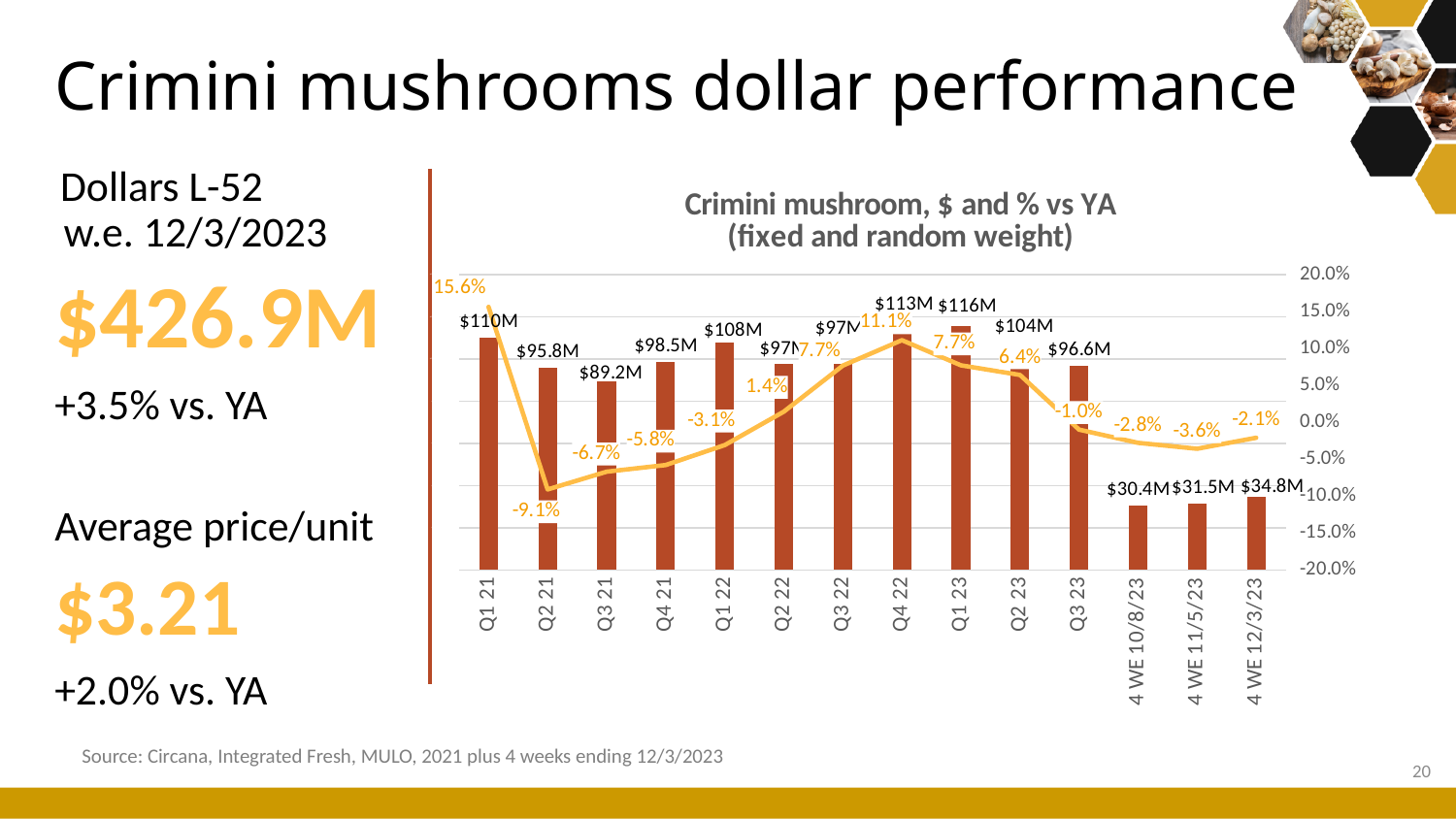
What is the % vs YA value shown for 4 WE 11/5/23? -3.6% Does the % vs YA line rise or fall from Q2 21 to Q4 22? Rises What is the difference in dollars between Q1 23 and Q4 22? $3M What is the dollar value shown for Q1 23? $116M Which has the larger dollar value, Q3 21 or Q4 21? Q4 21 Which period has the highest dollar bar? Q1 23 What kind of chart is this? Combination bar and line chart What is the dollar value shown for the 4 WE 12/3/23 period? $34.8M What is the % vs YA value shown for Q1 21? 15.6% Which period has the lowest % vs YA value on the line? Q2 21 Is the % vs YA value for Q4 22 greater or less than 10.0%? greater How many periods are shown on the x axis? 14